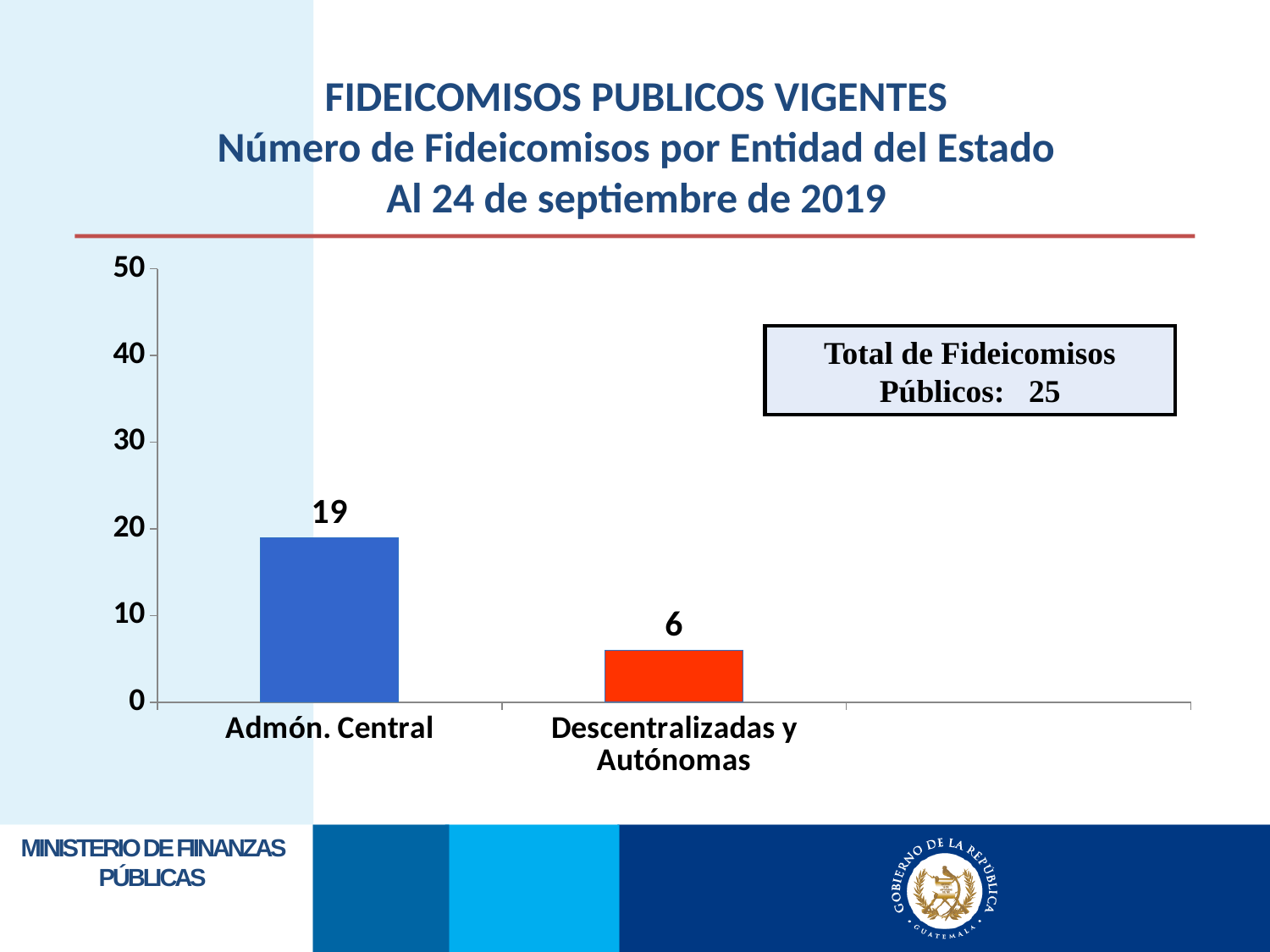
Is the value for Admón. Central greater or less than 10? greater Which category has the lowest number of fideicomisos? Descentralizadas y Autónomas Is the value for Descentralizadas y Autónomas greater or less than 10? less What is the difference between the values for Admón. Central and Descentralizadas y Autónomas? 13 Which is larger, the value for Admón. Central or for Descentralizadas y Autónomas? Admón. Central What kind of chart is shown on the slide? bar chart What is the total of the two bars shown on the chart? 25 Which category has the highest number of fideicomisos? Admón. Central What is the highest value shown on the vertical axis of the chart? 50 What is the number of fideicomisos for Descentralizadas y Autónomas? 6 How many categories are shown on the chart? 2 What is the number of fideicomisos for Admón. Central? 19